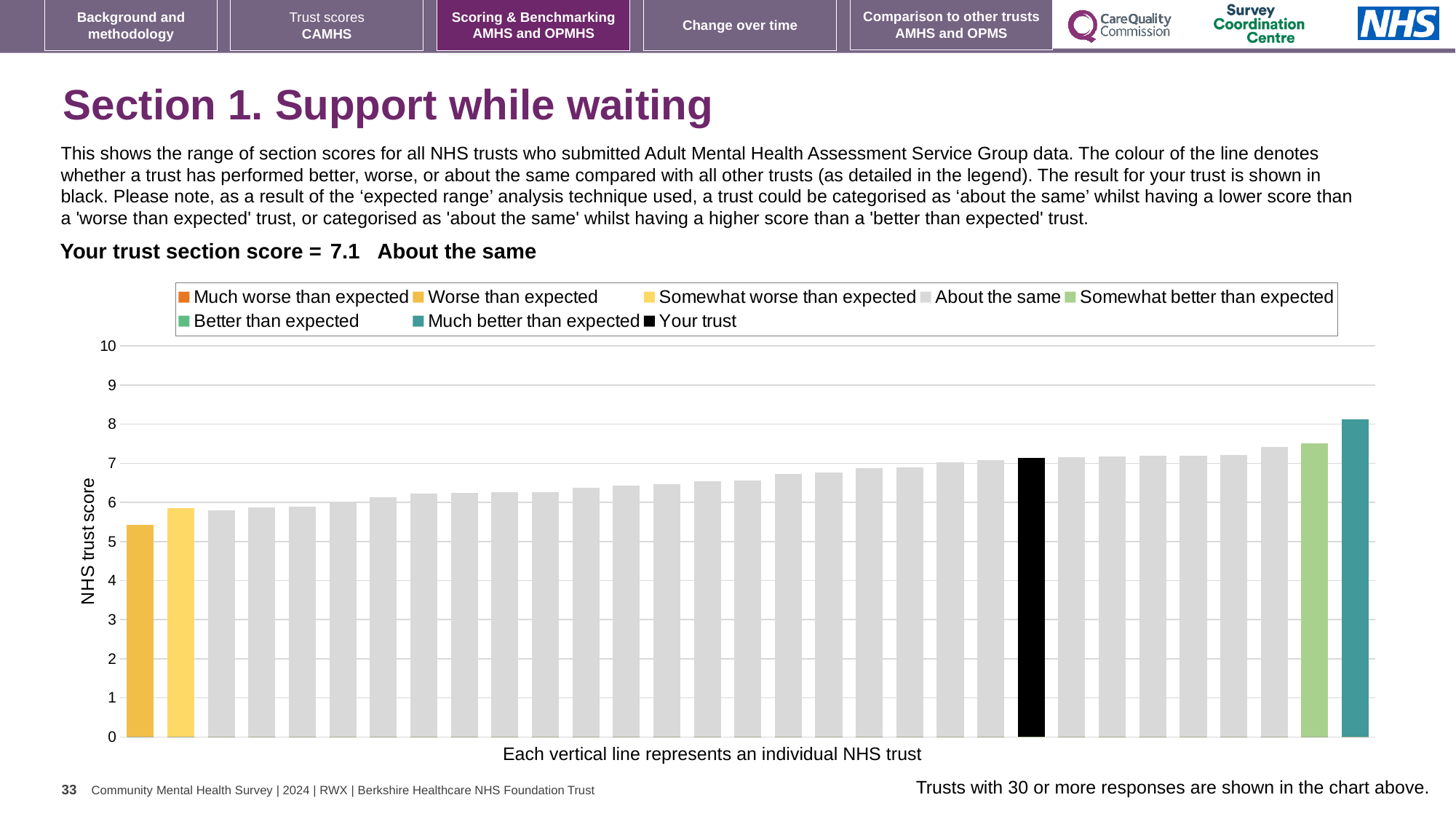
What kind of chart is shown on the slide? bar chart Which legend category does the highest bar in the chart belong to? Much better than expected How many entries does the chart legend list? 8 What is the title of the y axis? NHS trust score Do the bar values rise or fall from left to right along the x axis? rise Which category does your trust fall into according to the slide? About the same Is the value of the lowest bar in the chart greater or less than 6? less Is the value for your trust (black bar) greater or less than 8? less What is the section score for your trust shown on the slide? 7.1 Is the value of the lowest bar in the chart greater or less than 5? greater What is the highest tick value shown on the y axis? 10